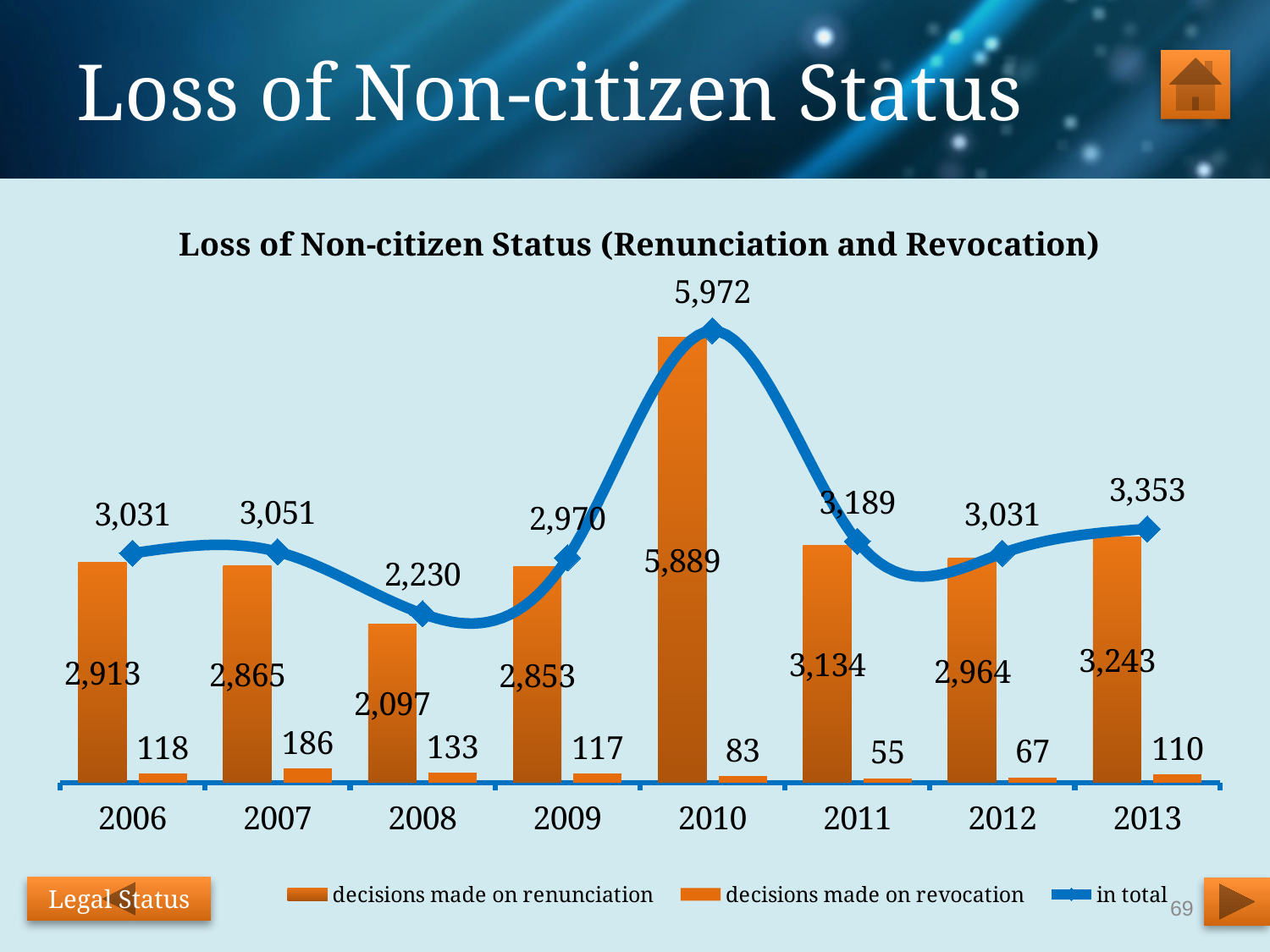
What is the 'in total' value for 2013? 3,353 What is the title of the chart? Loss of Non-citizen Status (Renunciation and Revocation) Which year has the highest 'in total' value? 2010 Which is larger: decisions made on renunciation in 2011 or in 2012? 2011 Does the 'in total' line rise or fall from 2011 to 2013? Rise What is the difference between the 'in total' values for 2010 and 2009? 3,002 How many series does the legend list? 3 What kind of chart is shown on the slide? Combined bar and line chart What is the value for decisions made on revocation in 2007? 186 How many years are shown on the x axis? 8 Which year has the lowest value for decisions made on revocation? 2011 What is the value for decisions made on renunciation in 2010? 5,889